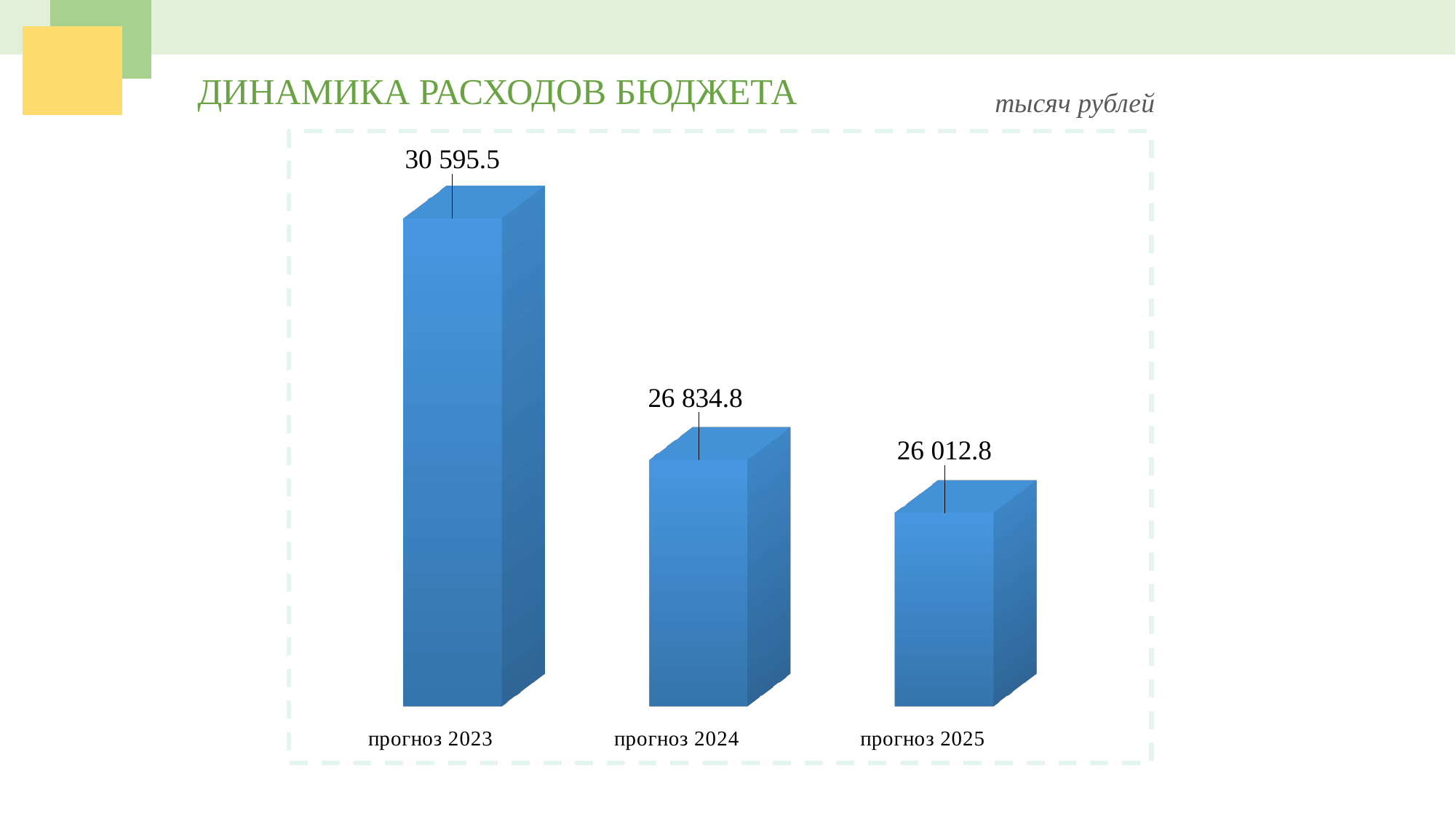
Which category has the highest value? прогноз 2023 How many categories are shown in the chart? 3 What is the value for прогноз 2025? 26 012.8 What is the difference between the values for прогноз 2024 and прогноз 2025? 822.0 What is the difference between the values for прогноз 2023 and прогноз 2024? 3 760.7 What is the value for прогноз 2024? 26 834.8 Which category has the lowest value? прогноз 2025 Do the values rise or fall from прогноз 2023 to прогноз 2025? fall What is the value for прогноз 2023? 30 595.5 Which is larger, the value for прогноз 2024 or прогноз 2025? прогноз 2024 What is the title of the chart? ДИНАМИКА РАСХОДОВ БЮДЖЕТА What kind of chart is shown on the slide? bar chart